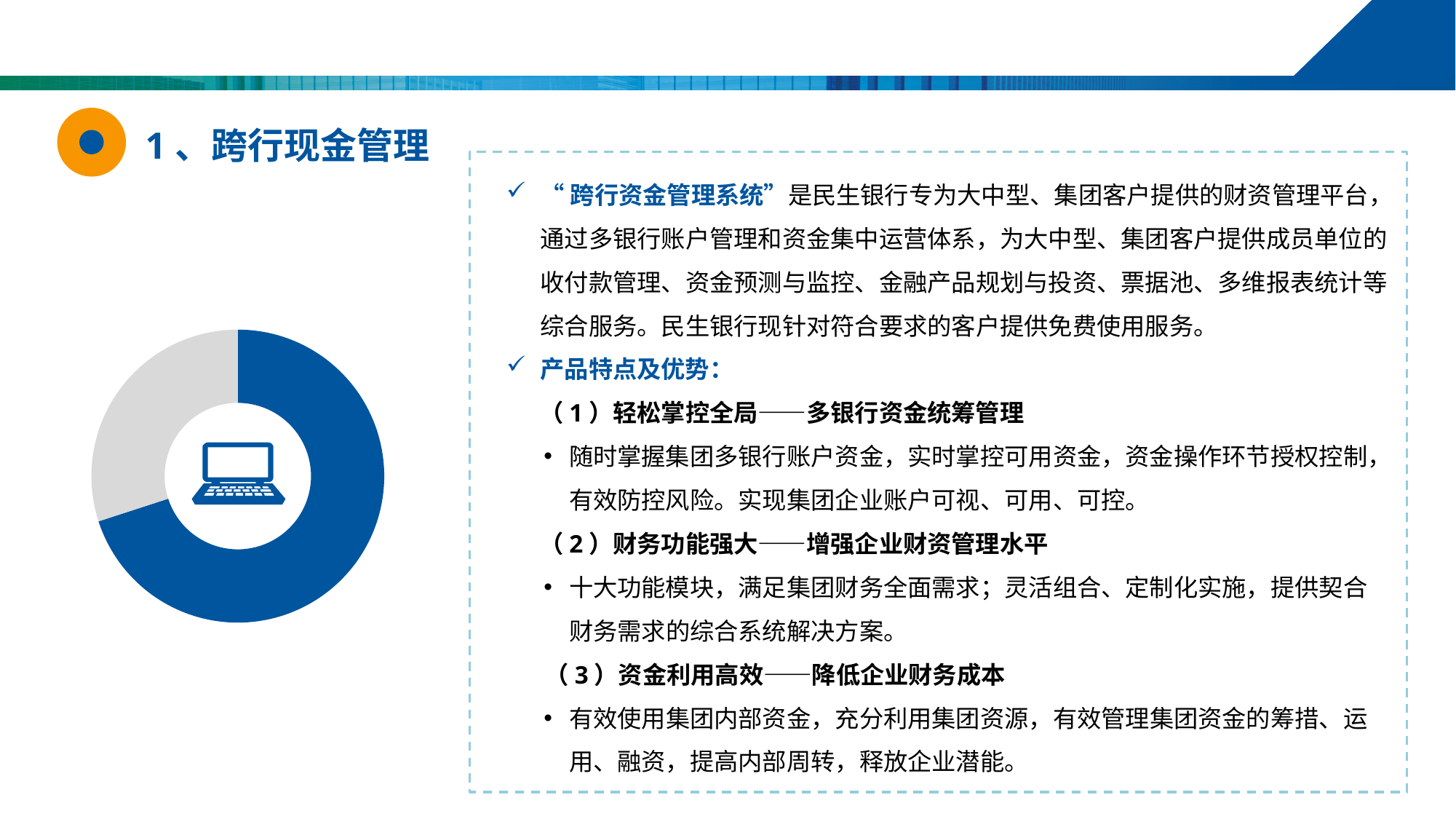
What icon is placed in the centre of the doughnut chart on the left of the slide? a laptop What kind of chart is shown on the left of the slide? doughnut chart How many segments does the doughnut chart on the left of the slide have? 2 Does the doughnut chart on the left of the slide show a legend? No In the doughnut chart on the left of the slide, which segment is larger, the blue one or the grey one? the blue one